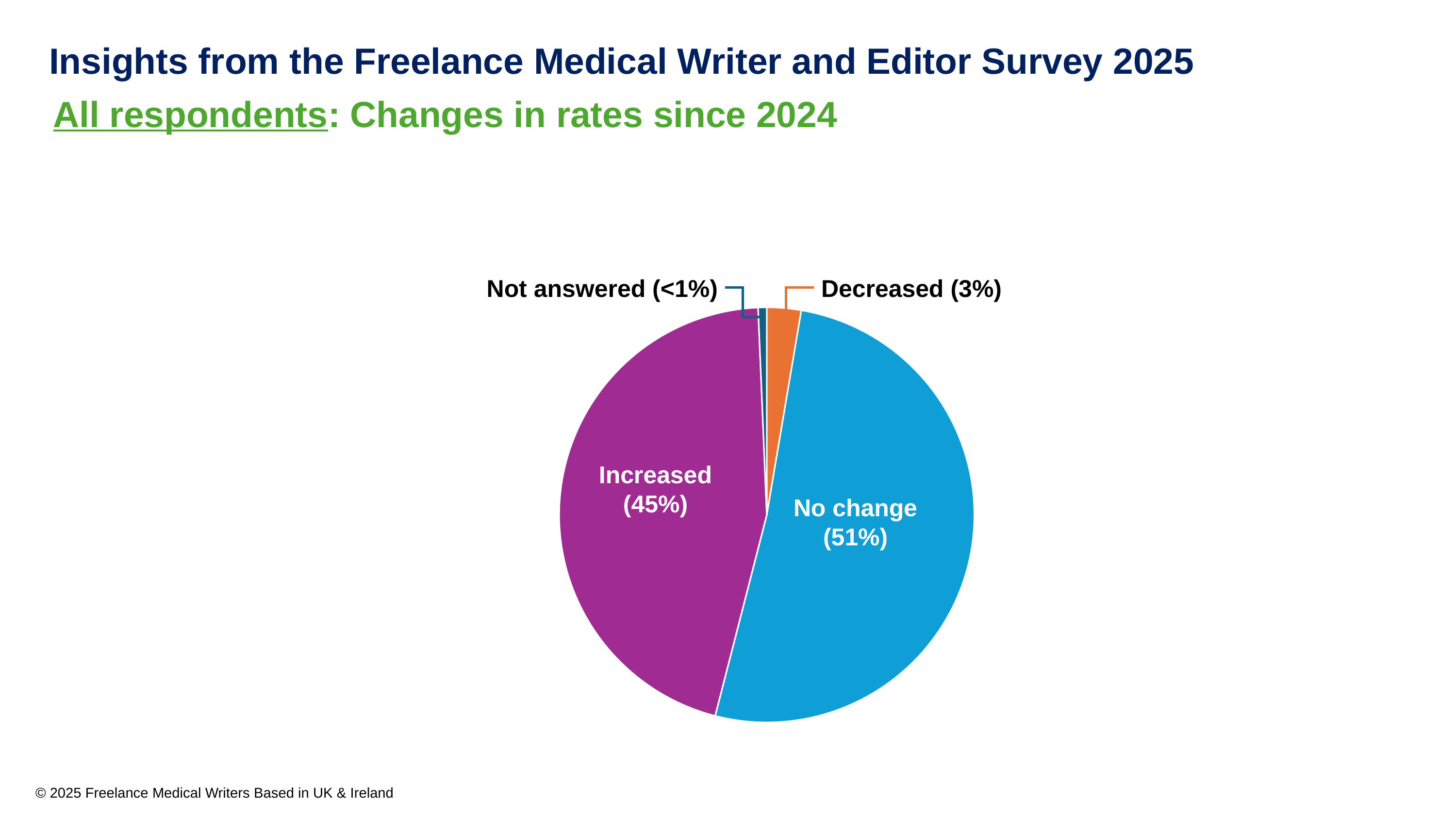
What share of respondents reported that their rates had increased? 45% How many slices does the pie chart have? 4 What share is shown for the 'Not answered' slice? <1% What colour is the 'Decreased' slice? Orange Which is larger: the share for 'Increased' or the share for 'No change'? No change Which category has the smallest slice of the pie? Not answered What is the difference in percentage points between 'No change' and 'Increased'? 6 What is the difference in percentage points between 'Increased' and 'Decreased'? 42 What share of respondents reported no change in rates? 51% Which category has the largest slice of the pie? No change What share of respondents reported that their rates had decreased? 3% What kind of chart is shown on the slide? Pie chart